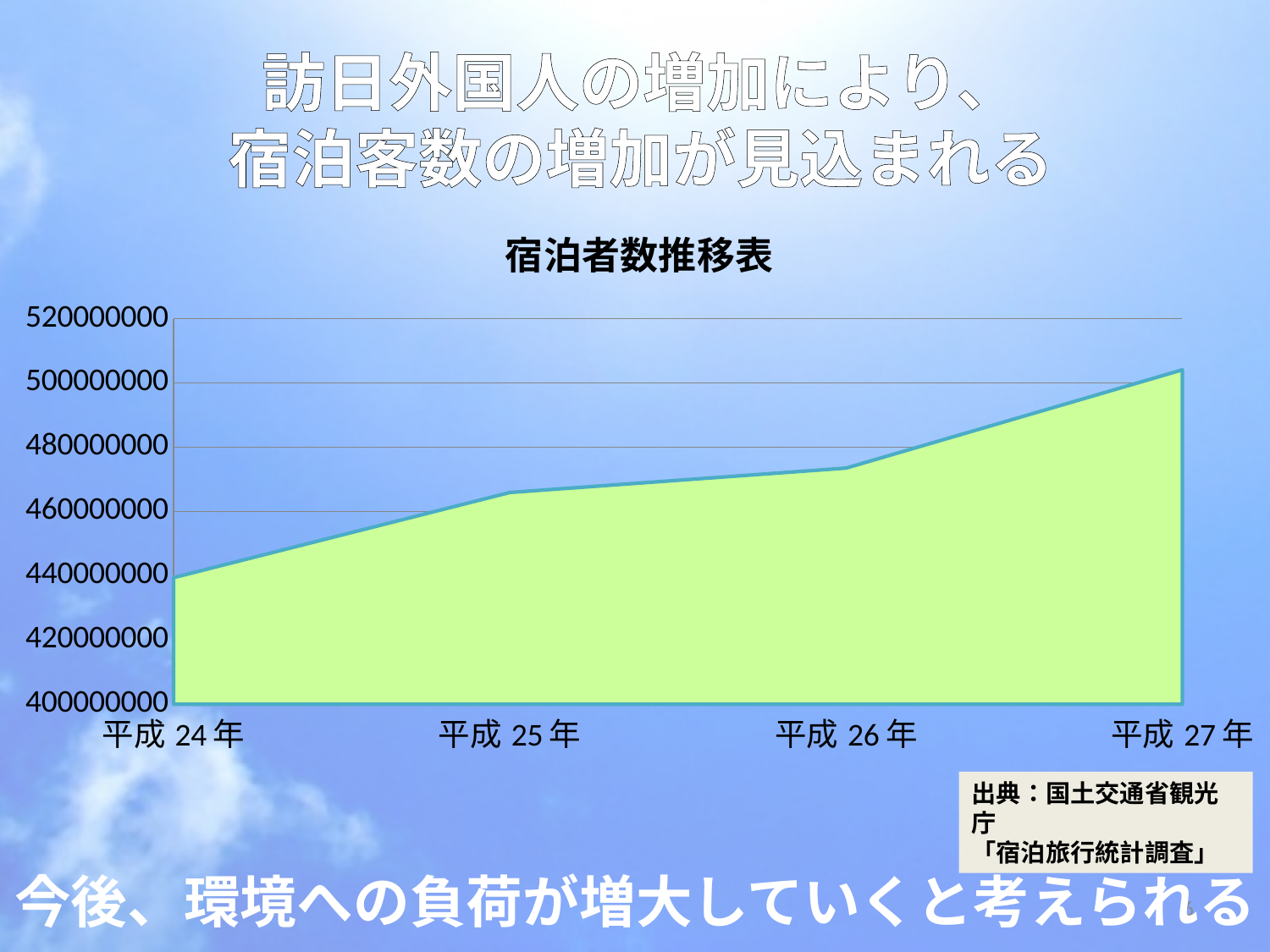
How many years are plotted along the x axis of the chart? 4 Do the values rise or fall from 平成24年 to 平成27年? rise Is the value for 平成26年 greater or less than 480000000? less Is the value for 平成27年 greater or less than 480000000? greater Is the value for 平成25年 greater or less than 460000000? greater Which year has the lowest value in the chart? 平成24年 Which is larger, the value for 平成24年 or the value for 平成27年? 平成27年 What is the title of the chart? 宿泊者数推移表 Which year has the highest value in the chart? 平成27年 What kind of chart is shown on the slide? area chart What is the lowest value shown on the y axis of the chart? 400000000